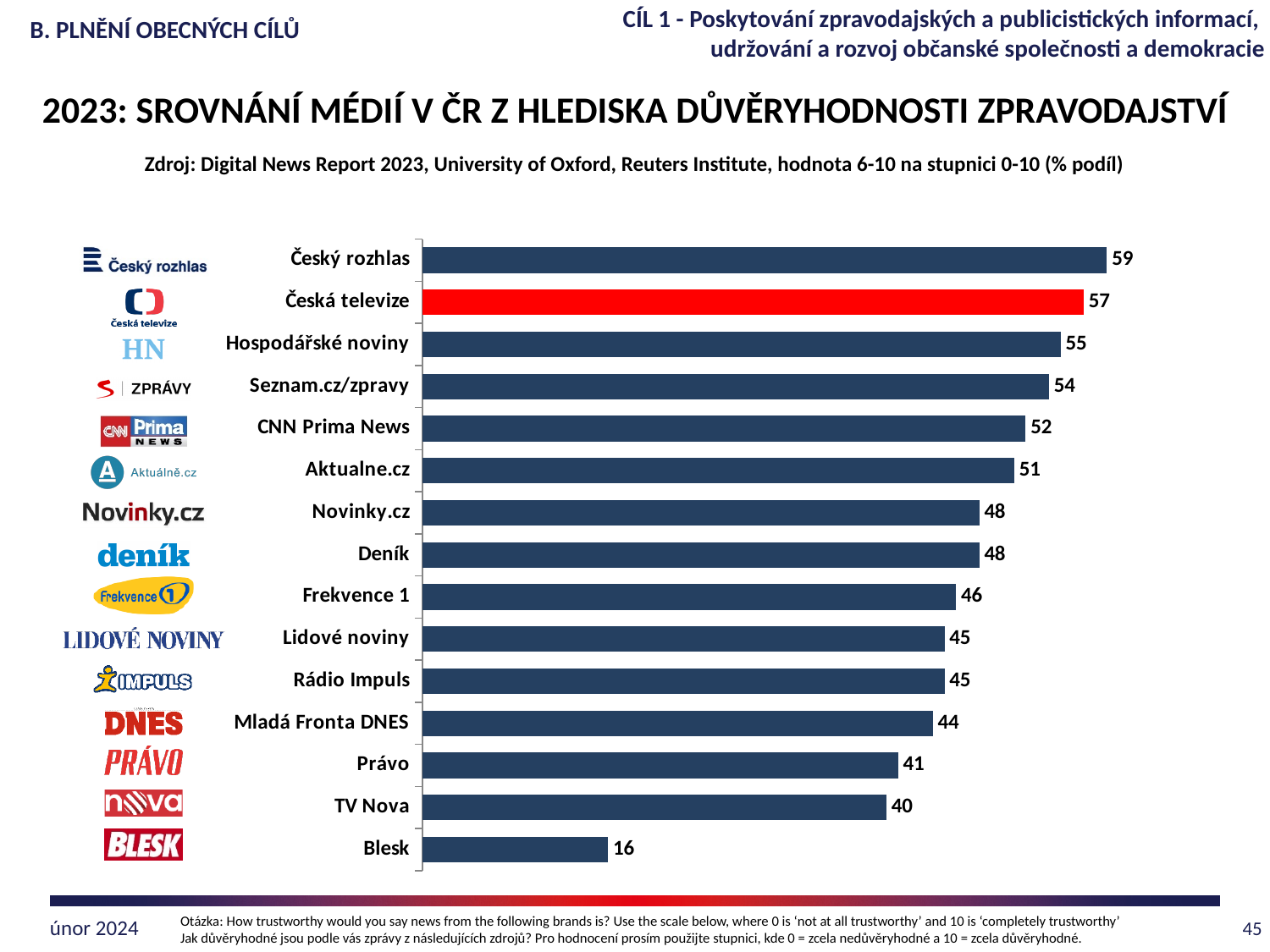
Which category has the lowest value? Blesk Which category has the highest value? Český rozhlas How many categories are shown in the chart? 15 What is the value for Blesk? 16 Which bar is coloured red rather than dark blue? Česká televize What is the value for Mladá Fronta DNES? 44 What kind of chart is shown on the slide? bar chart What is the difference between the values for Český rozhlas and Česká televize? 2 What is the value for Seznam.cz/zpravy? 54 Which is larger, the value for CNN Prima News or the value for Aktualne.cz? CNN Prima News What is the difference between the values for TV Nova and Blesk? 24 What is the value for Česká televize? 57